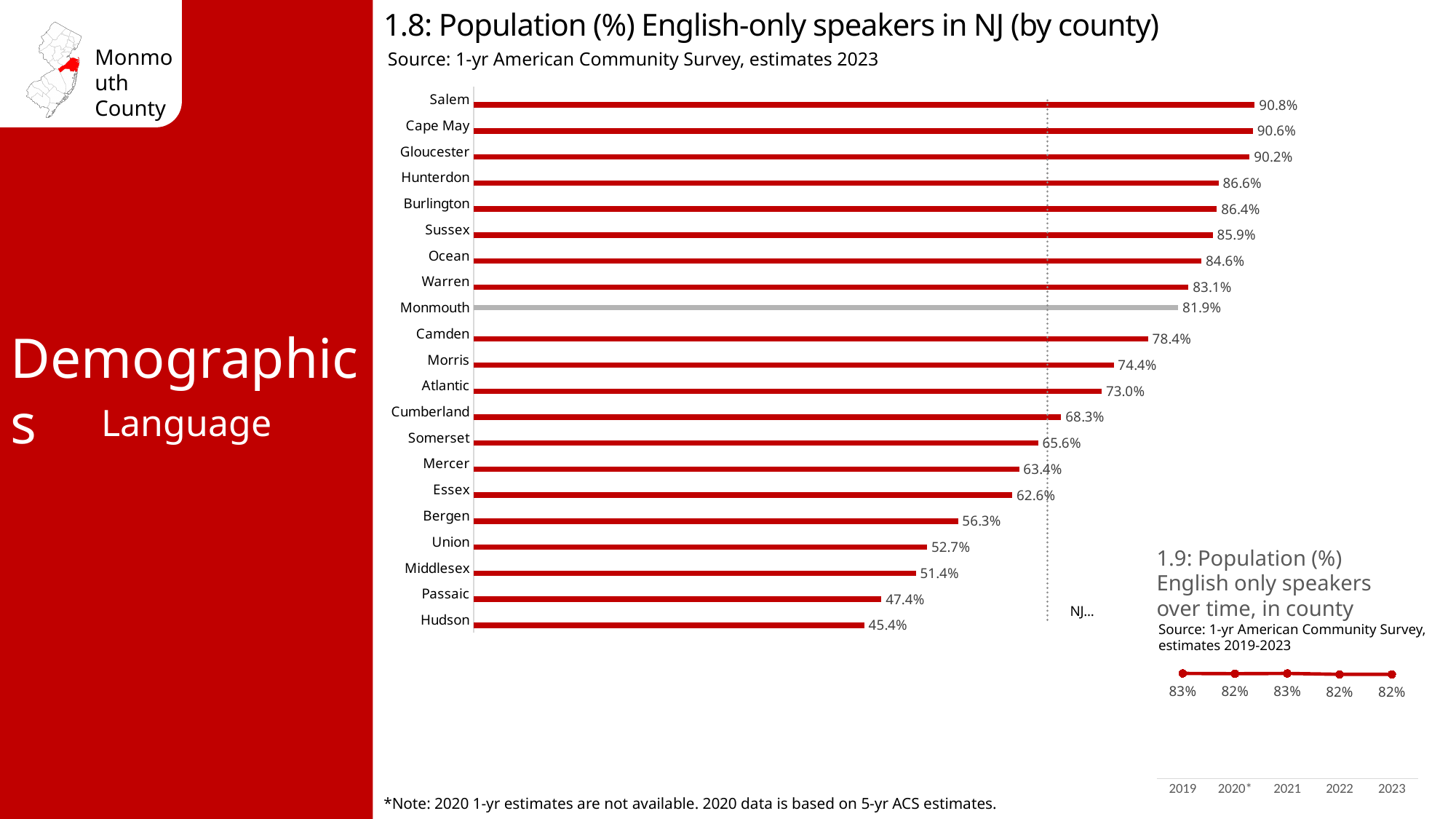
In chart 1.8, which is larger, the value for Camden or the value for Morris? Camden In chart 1.8, which county has the highest percentage of English-only speakers? Salem What kind of chart is chart 1.8? Bar chart In chart 1.9, how many years are plotted? 5 In chart 1.8, which county has the lowest percentage of English-only speakers? Hudson In chart 1.9, what is the value for 2023? 82% In chart 1.8, what is the value for Hudson? 45.4% In chart 1.8, what is the difference between the values for Monmouth and Warren? 1.2% In chart 1.8, what is the difference between the values for Salem and Hudson? 45.4% In chart 1.8, how many counties are shown? 21 In chart 1.8, which county's bar is shown in grey instead of red? Monmouth In chart 1.8, what is the value for Monmouth? 81.9%